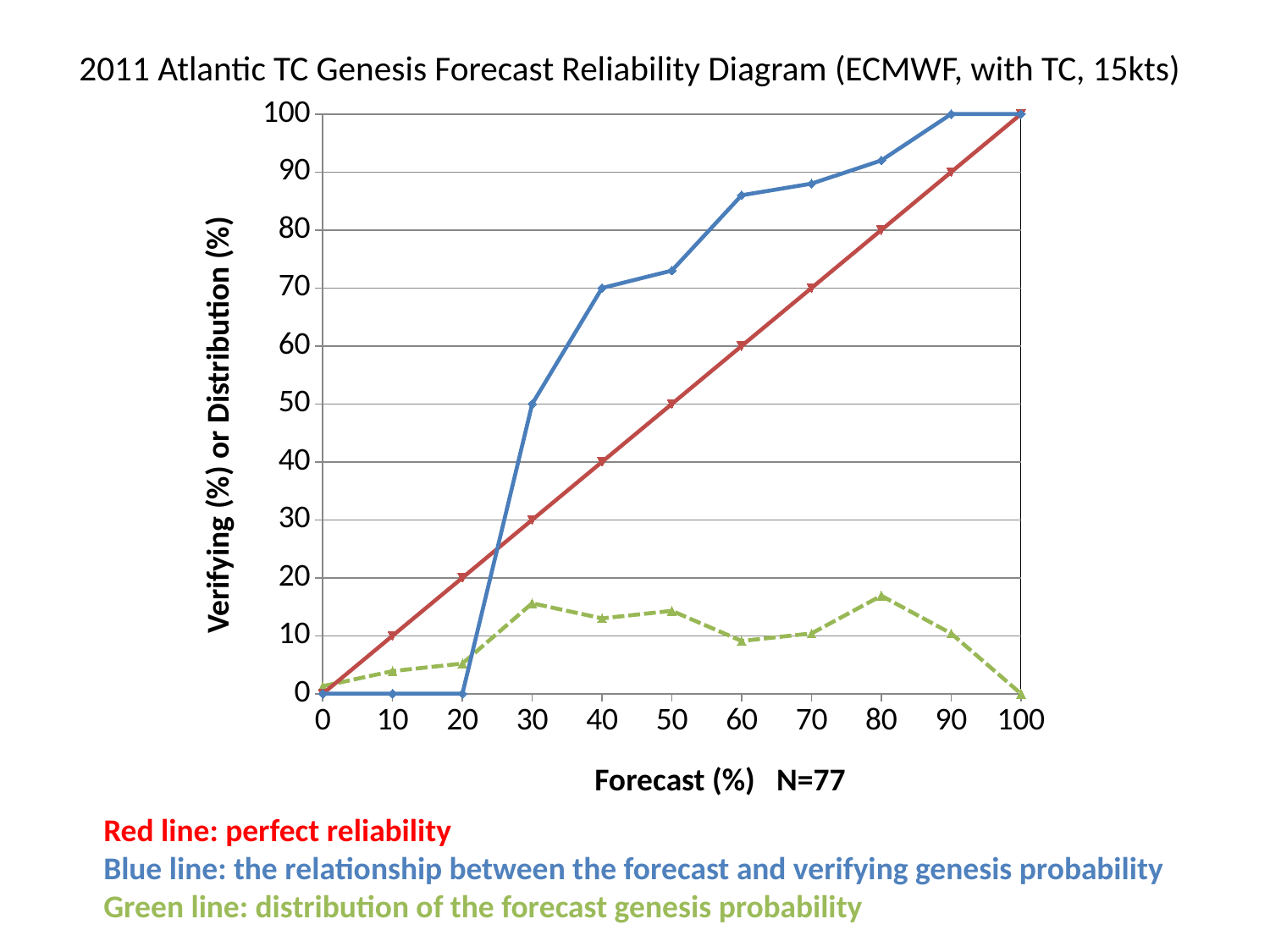
What is the title of the chart? 2011 Atlantic TC Genesis Forecast Reliability Diagram (ECMWF, with TC, 15kts) Is the value of the blue line at a forecast of 60% greater or less than 80? greater What is the value of the blue line at a forecast of 30%? 50 What is the value of the red (perfect reliability) line at a forecast of 50%? 50 At a forecast of 60%, which line has the higher value, the blue line or the red line? blue line Is the value of the green dashed line at a forecast of 80% greater or less than 20? less What is the value of the blue line at a forecast of 20%? 0 How many lines are plotted on the chart? 3 How many forecast points are plotted along the x axis for each line? 11 What is the value of the blue line at a forecast of 40%? 70 What kind of chart is shown on the slide? line chart Does the red line rise or fall as the forecast percentage increases? rise